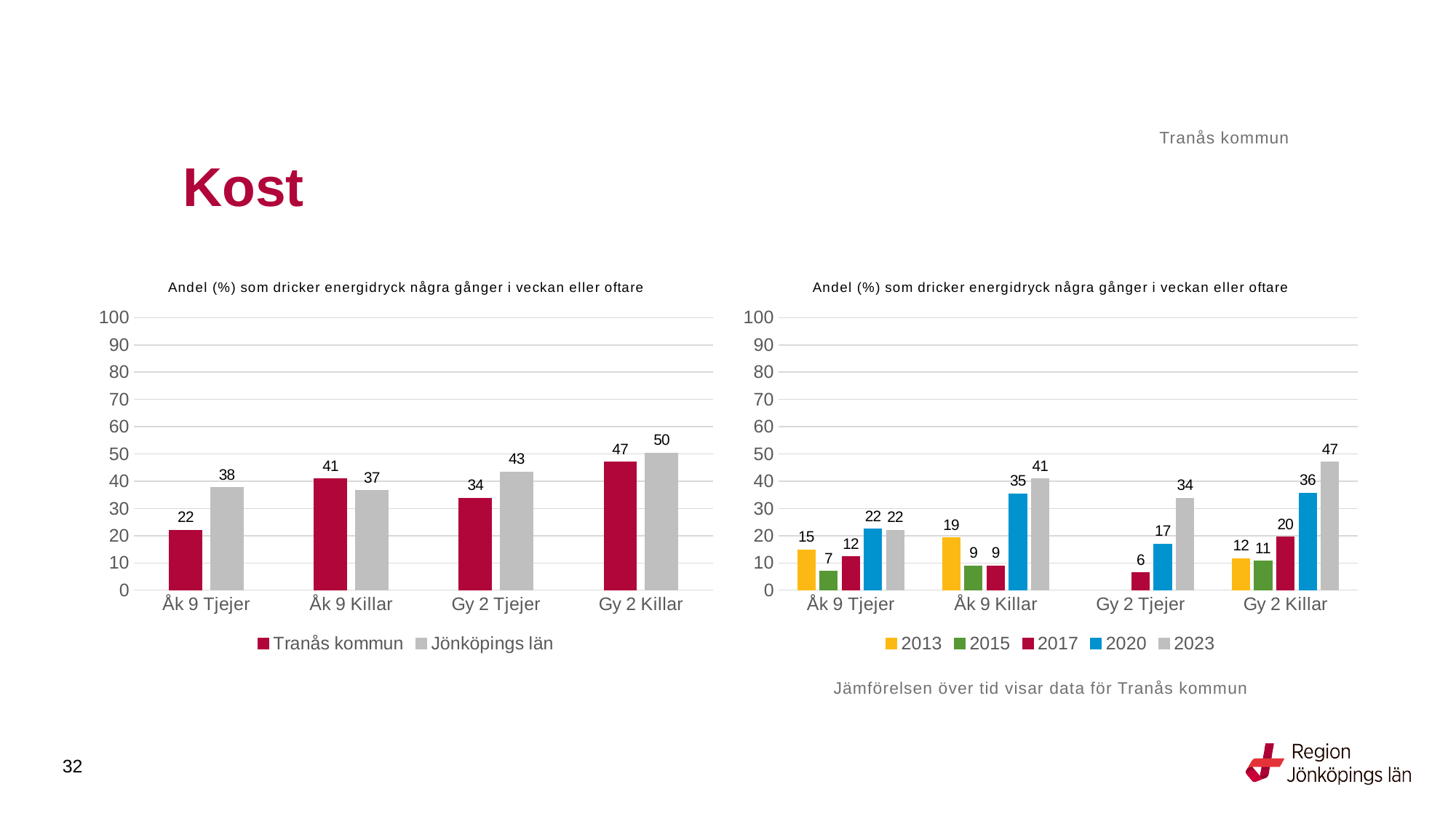
In the left chart, which category has the highest value for Jönköpings län? Gy 2 Killar In the left chart, what is the value for Tranås kommun for Åk 9 Killar? 41 In the left chart, what is the value for Jönköpings län for Gy 2 Tjejer? 43 In the right chart, what is the difference between 2023 and 2013 for Gy 2 Killar? 35 In the left chart, which category has the lowest value for Tranås kommun? Åk 9 Tjejer In the right chart, what is the value for 2017 for Gy 2 Tjejer? 6 In the left chart, what is the difference between Jönköpings län and Tranås kommun for Åk 9 Tjejer? 16 What kind of chart is the left chart? Bar chart In the right chart, which year has the highest value for Gy 2 Tjejer? 2023 In the right chart, how many series does the legend list? 5 In the right chart, what is the value for 2020 for Åk 9 Killar? 35 In the left chart, which is larger for Åk 9 Killar: Tranås kommun or Jönköpings län? Tranås kommun